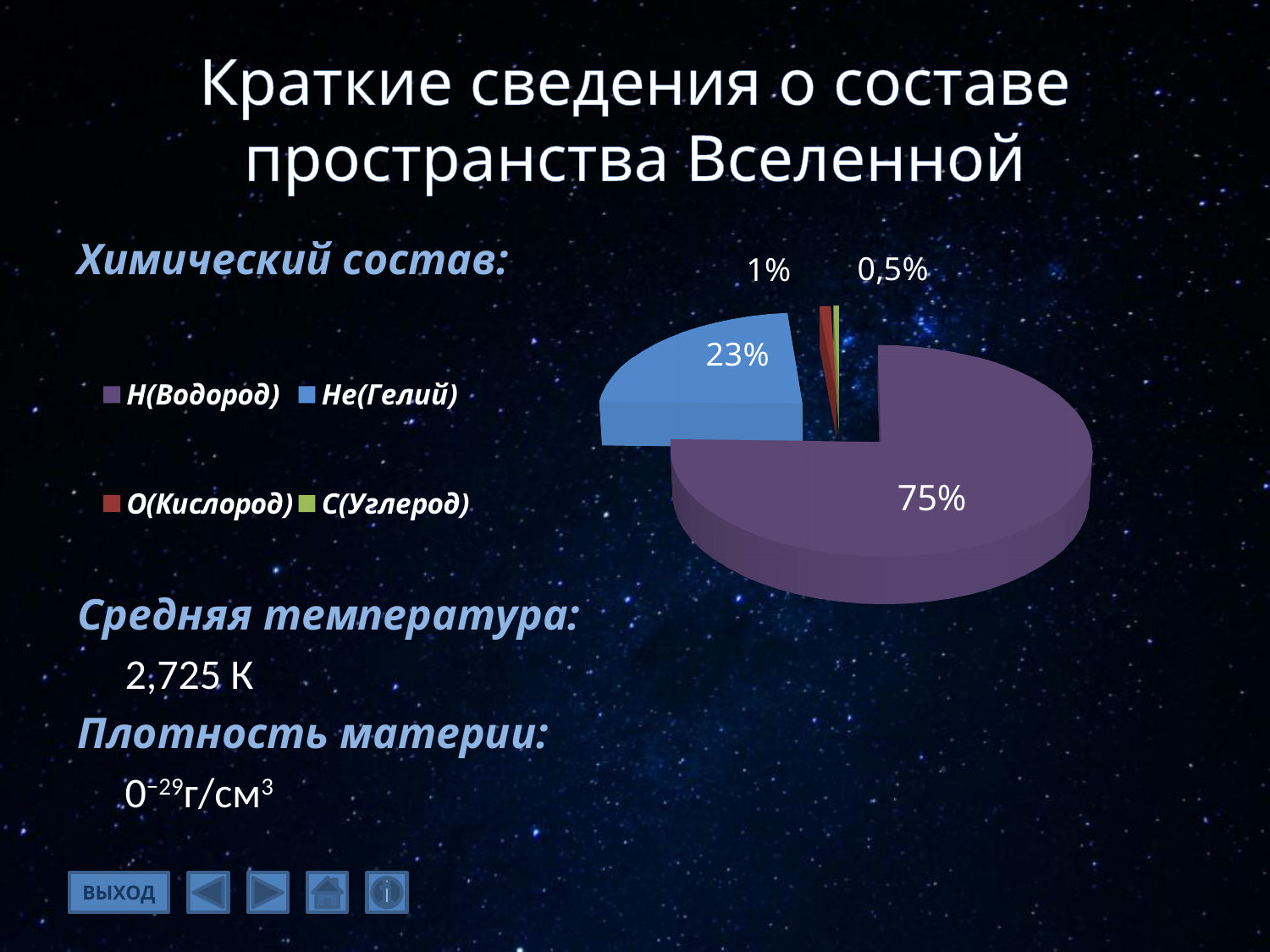
What share of the pie does He(Гелий) have? 23% What is the difference between the shares of H(Водород) and He(Гелий)? 52% What share of the pie does H(Водород) have? 75% Which is larger in the pie chart, He(Гелий) or O(Кислород)? He(Гелий) What kind of chart is shown on the slide? pie chart What colour is the He(Гелий) slice in the pie chart? blue How many slices does the pie chart have? 4 Which category has the smallest slice in the pie chart? C(Углерод) Which category has the largest slice in the pie chart? H(Водород) What value is shown for O(Кислород) in the pie chart? 1% What value is shown for C(Углерод) in the pie chart? 0,5% How many entries does the legend of the pie chart list? 4